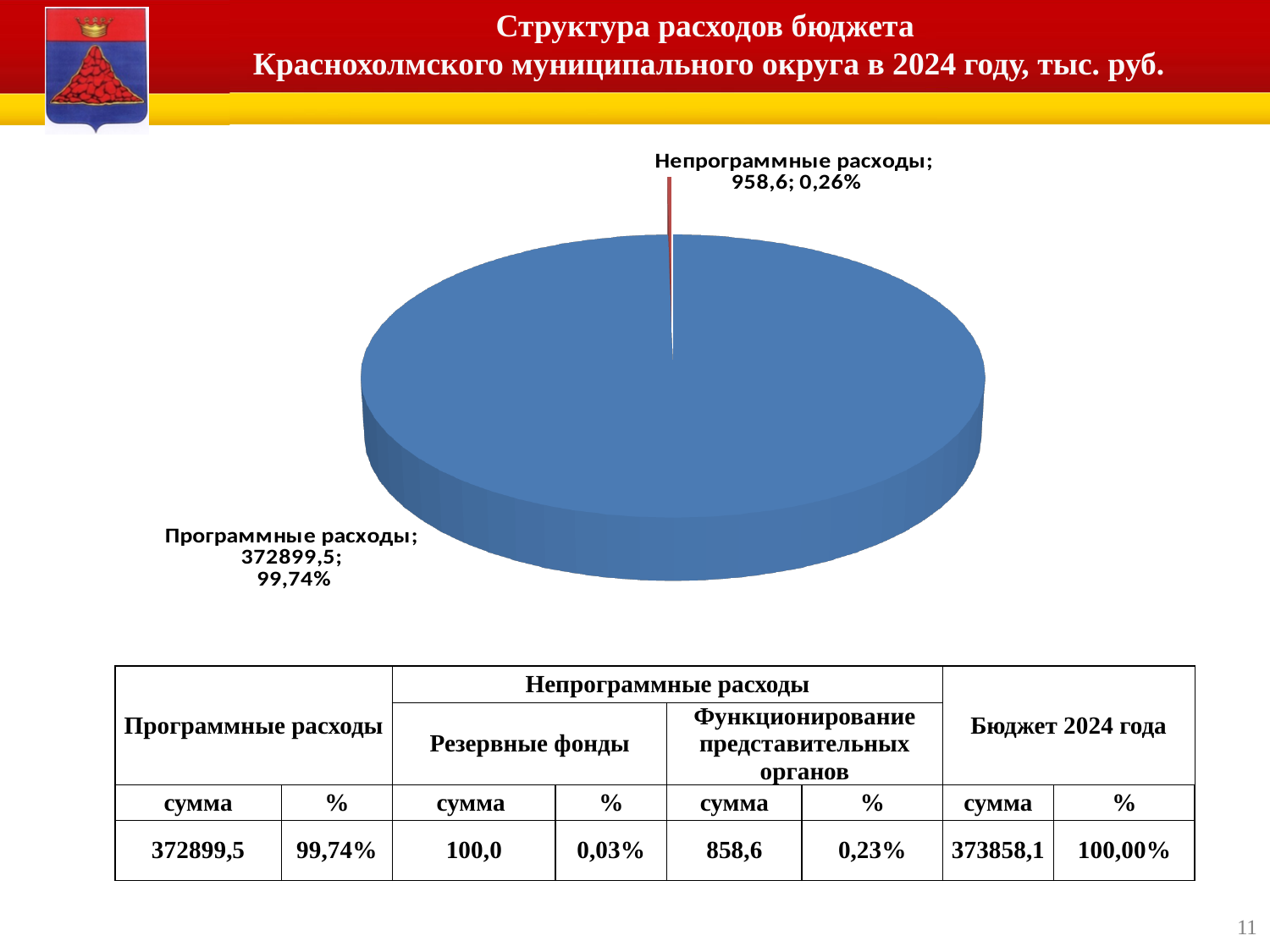
What share of the pie does Программные расходы represent? 99,74% What is the value shown for Непрограммные расходы on the pie chart? 958,6 What share of the pie does Непрограммные расходы represent? 0,26% What is the title of the chart on the slide? Структура расходов бюджета Краснохолмского муниципального округа в 2024 году, тыс. руб. How many slices does the pie chart have? 2 What is the difference between the values for Программные расходы and Непрограммные расходы? 371940,9 Which category has the largest slice of the pie chart? Программные расходы What is the total of the two values shown on the pie chart? 373858,1 Which is larger, Программные расходы or Непрограммные расходы? Программные расходы What type of chart is shown on the slide? Pie chart What is the value shown for Программные расходы on the pie chart? 372899,5 Which category has the smallest slice of the pie chart? Непрограммные расходы